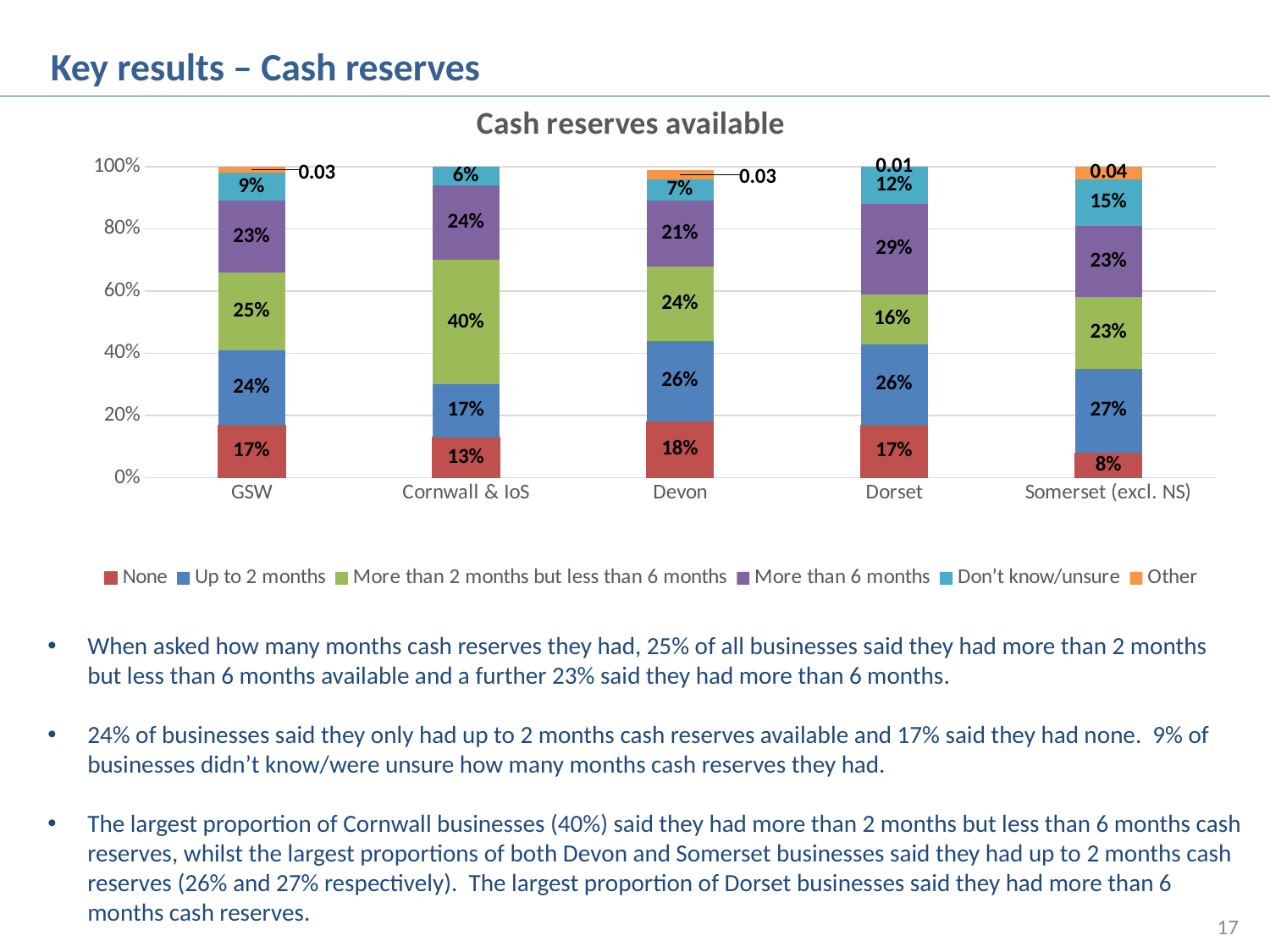
What percentage of Somerset (excl. NS) businesses said they had no cash reserves (None)? 8% Which region has the lowest 'None' value? Somerset (excl. NS) How many regions (categories) are shown on the x axis of the chart? 5 What percentage of Cornwall & IoS businesses said they had more than 2 months but less than 6 months of cash reserves? 40% How many series does the legend list? 6 What is the 'Don't know/unsure' value for GSW? 9% What is the difference between the 'Up to 2 months' values for Somerset (excl. NS) and Cornwall & IoS? 10% Which region has the highest 'More than 2 months but less than 6 months' value? Cornwall & IoS What percentage of Dorset businesses said they had more than 6 months of cash reserves? 29% What is the title of the chart? Cash reserves available Which is larger: the 'Don't know/unsure' value for Dorset or for Devon? Dorset What type of chart is shown on the slide? stacked bar chart